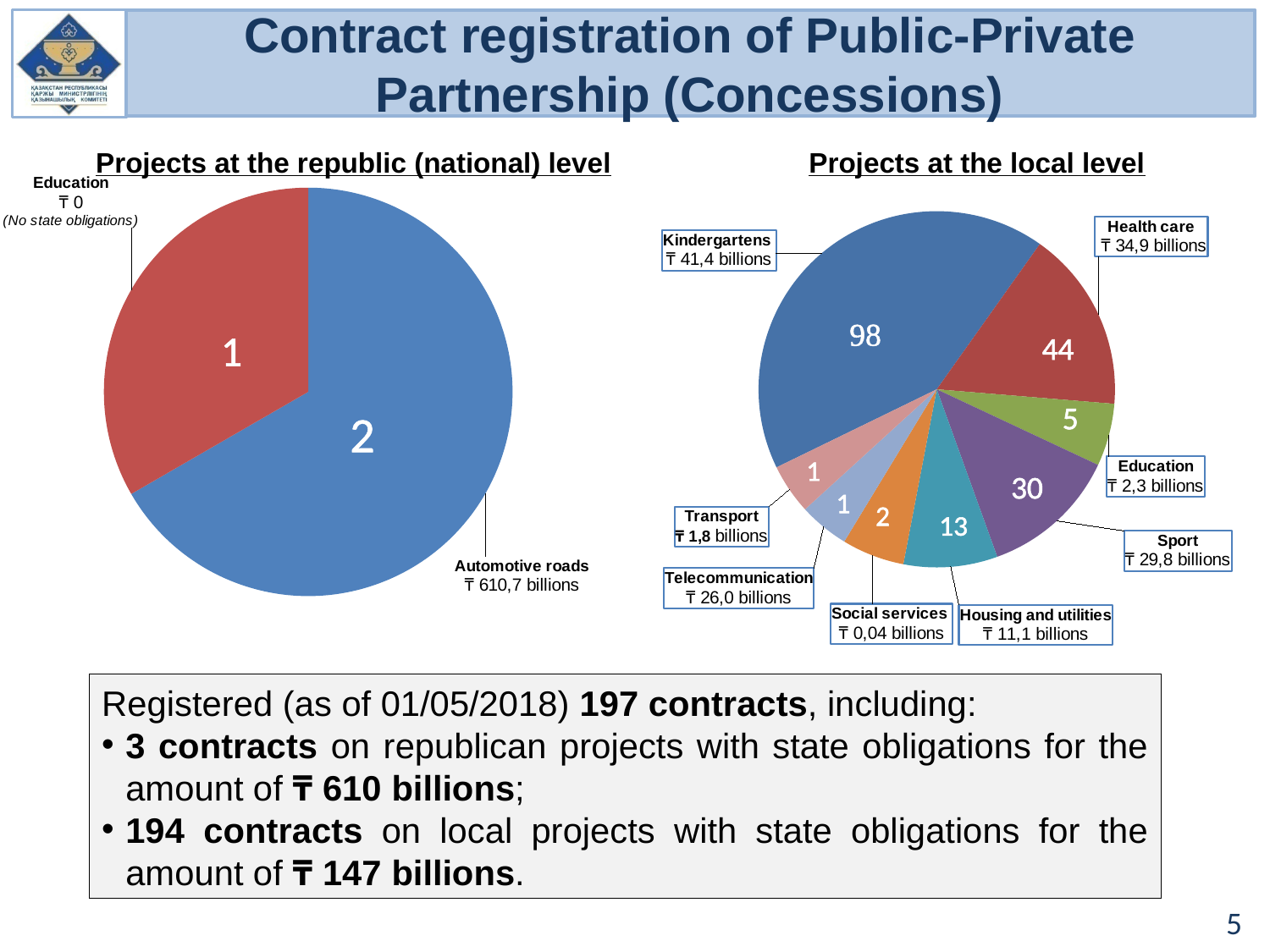
In the 'Projects at the local level' chart, which has more projects, Sport or Housing and utilities? Sport In the 'Projects at the local level' chart, how many categories are shown? 8 In the 'Projects at the local level' chart, what amount is shown for Health care? ₸ 34,9 billions What kind of chart is used for 'Projects at the republic (national) level'? Pie chart In the 'Projects at the local level' chart, which category has the largest slice? Kindergartens In the 'Projects at the republic (national) level' chart, how many slices does the pie have? 2 In the 'Projects at the local level' chart, what amount is shown for Social services? ₸ 0,04 billions In the 'Projects at the local level' chart, what is the total number of projects across all slices? 194 In the 'Projects at the republic (national) level' chart, what amount is shown for Automotive roads? ₸ 610,7 billions In the 'Projects at the local level' chart, how many projects are in the Kindergartens slice? 98 In the 'Projects at the local level' chart, what is the difference in number of projects between Kindergartens and Health care? 54 In the 'Projects at the republic (national) level' chart, how many projects are in the Automotive roads slice? 2